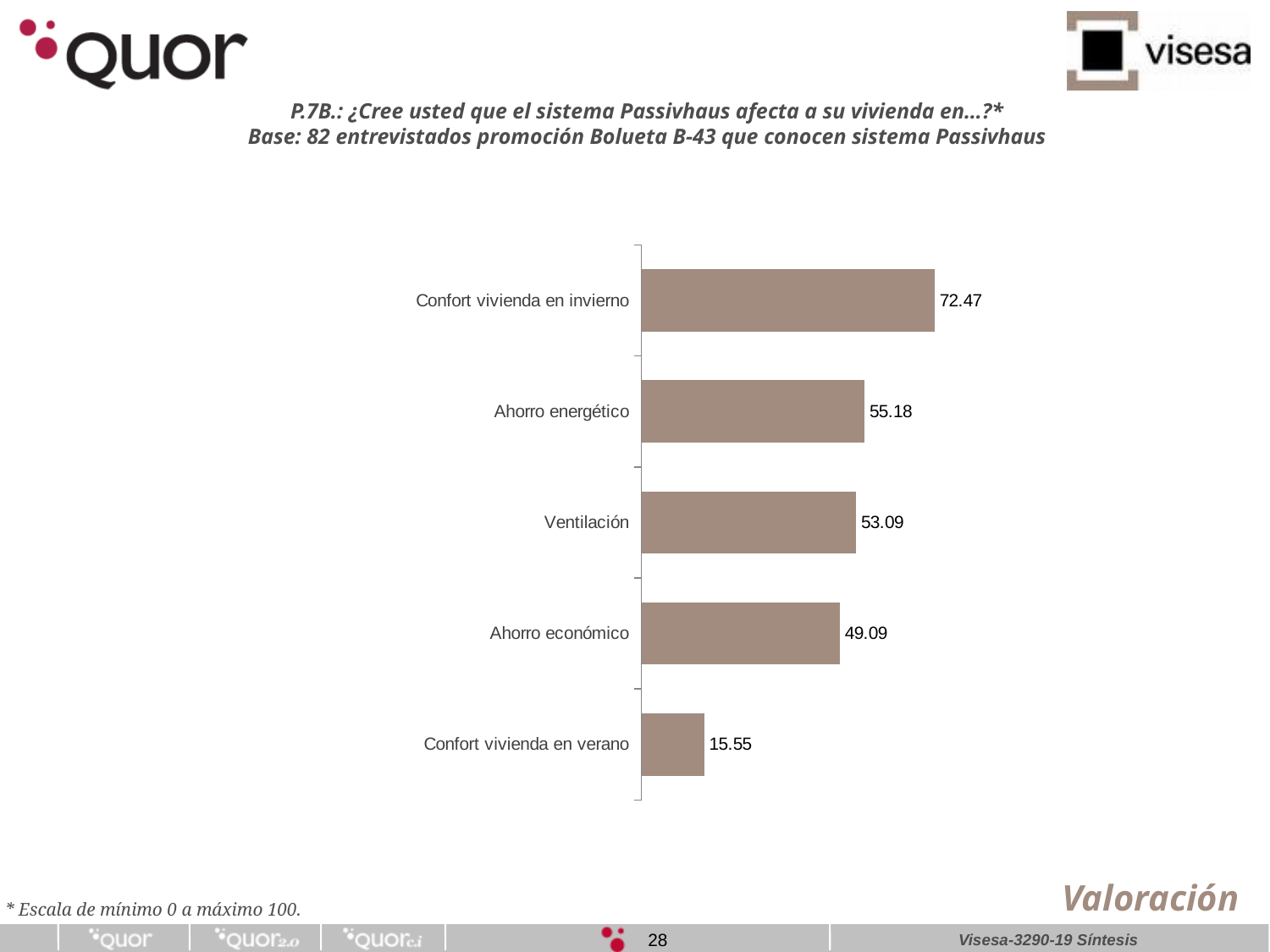
What is the value for Ahorro energético? 55.18 Which is larger, the value for Ahorro energético or the value for Ahorro económico? Ahorro energético What is the value for Ahorro económico? 49.09 How many categories are shown in the chart? 5 What is the value for Confort vivienda en verano? 15.55 Which category has the lowest value? Confort vivienda en verano What is the difference between the values for Ahorro energético and Ahorro económico? 6.09 What kind of chart is shown on the slide? Bar chart What is the value for Confort vivienda en invierno? 72.47 What is the value for Ventilación? 53.09 Which category has the highest value? Confort vivienda en invierno What is the difference between the values for Confort vivienda en invierno and Confort vivienda en verano? 56.92